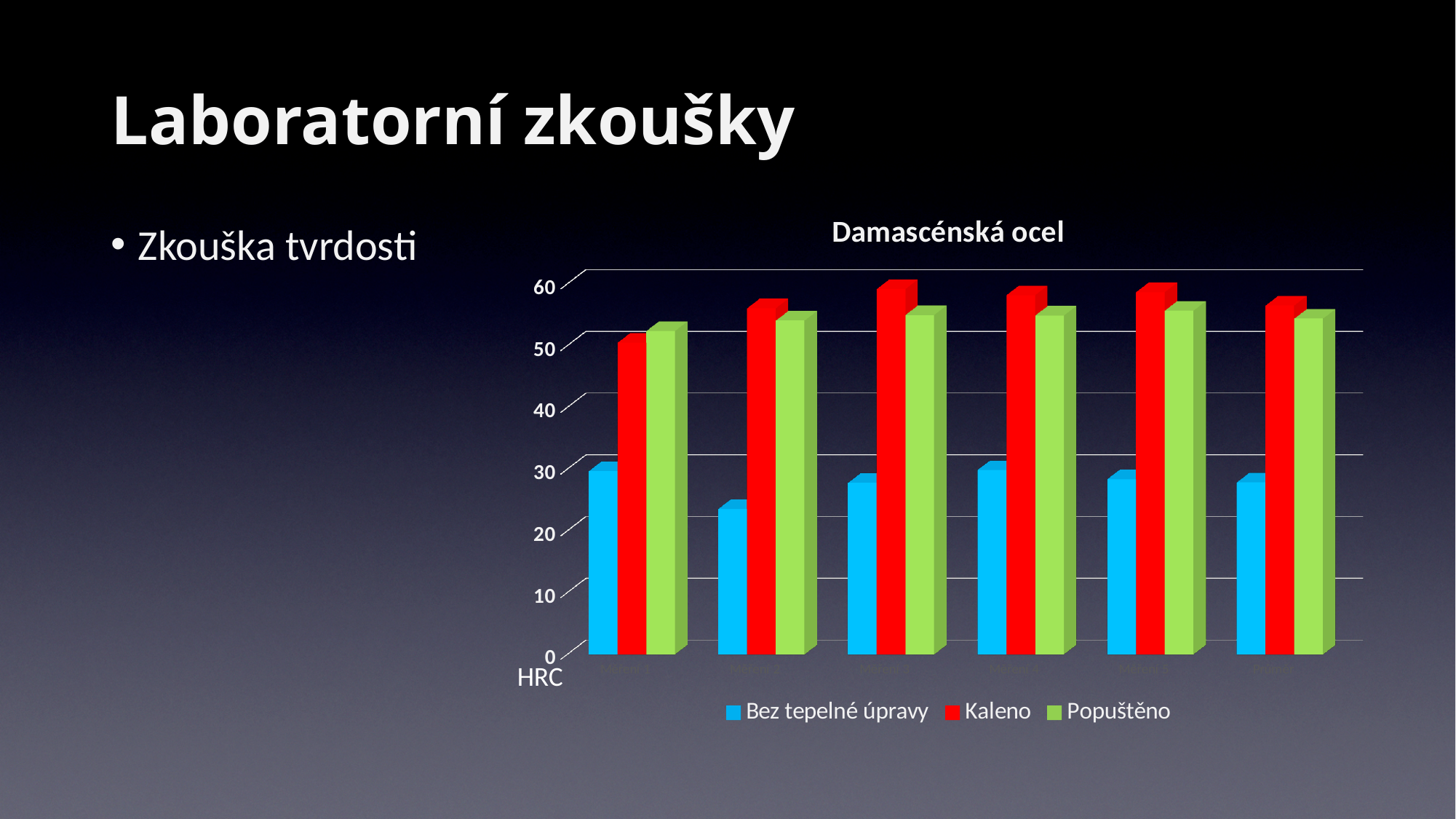
In the leftmost group of bars, is the value for Bez tepelné úpravy greater or less than 40? less In the third group of bars from the left, is the value for Popuštěno greater or less than 50? greater What kind of chart is shown on the slide? bar chart In the leftmost group of bars, is the value for Kaleno greater or less than 40? greater How many series does the chart legend list? 3 Which series has the lowest values in every group of bars? Bez tepelné úpravy How many groups of bars are plotted in the chart? 6 In the rightmost group of bars, which is larger: the value for Kaleno or the value for Bez tepelné úpravy? Kaleno Which series are listed in the chart legend? Bez tepelné úpravy, Kaleno, Popuštěno What is the title of the chart? Damascénská ocel